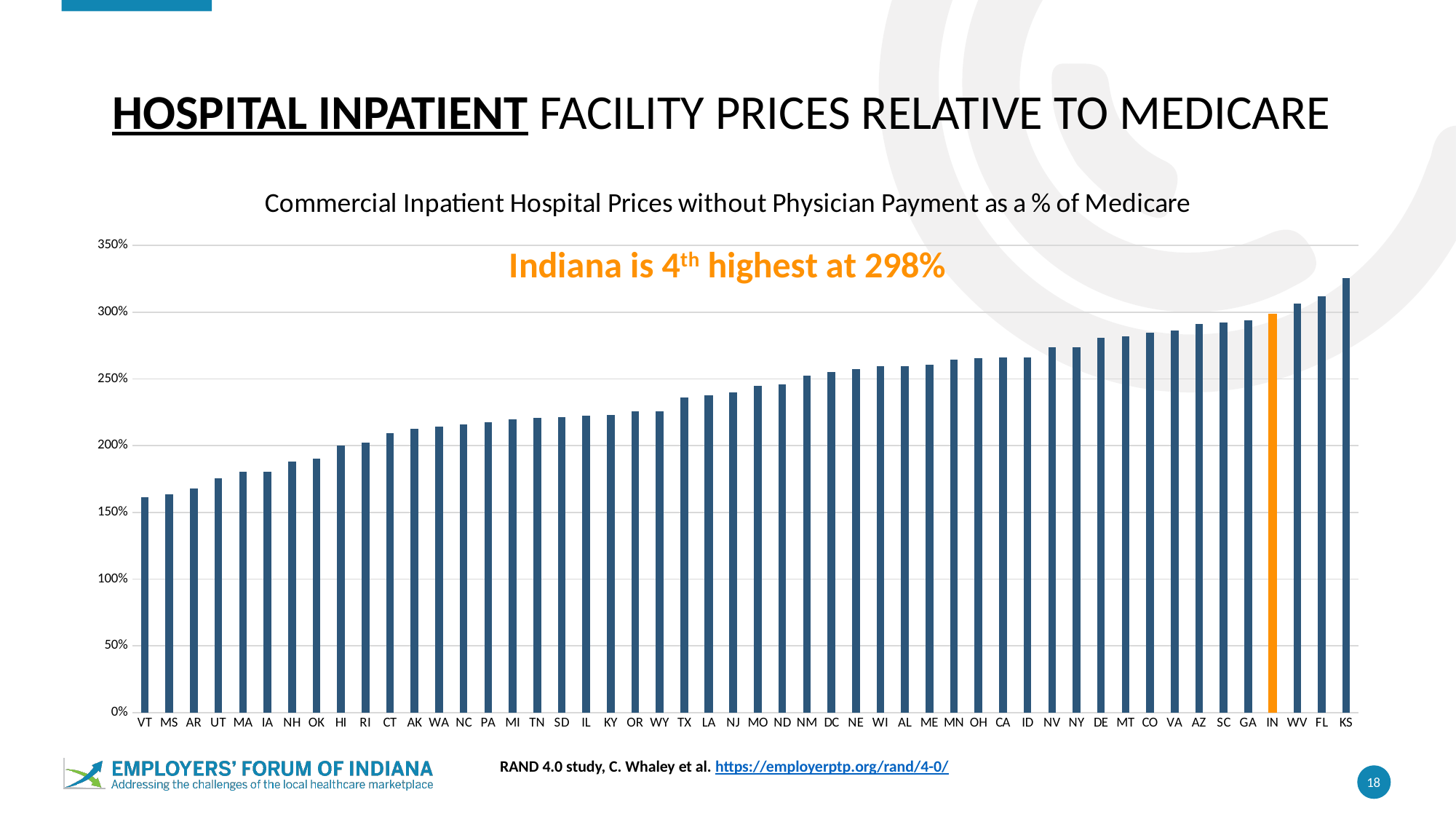
Is the value for MS greater or less than 150%? greater How many states/categories are plotted in the chart? 50 Is the value for KS greater or less than 300%? greater Which state has the highest value in the chart? KS Which state has the lowest value in the chart? VT Do the values rise or fall moving from left to right along the x axis? rise What type of chart is shown on the slide? bar chart Is the value for TX greater or less than 200%? greater Which has a larger value, NJ or NH? NJ What is the value for IN (Indiana) in the chart? 298% Which bar is highlighted in orange in the chart? IN